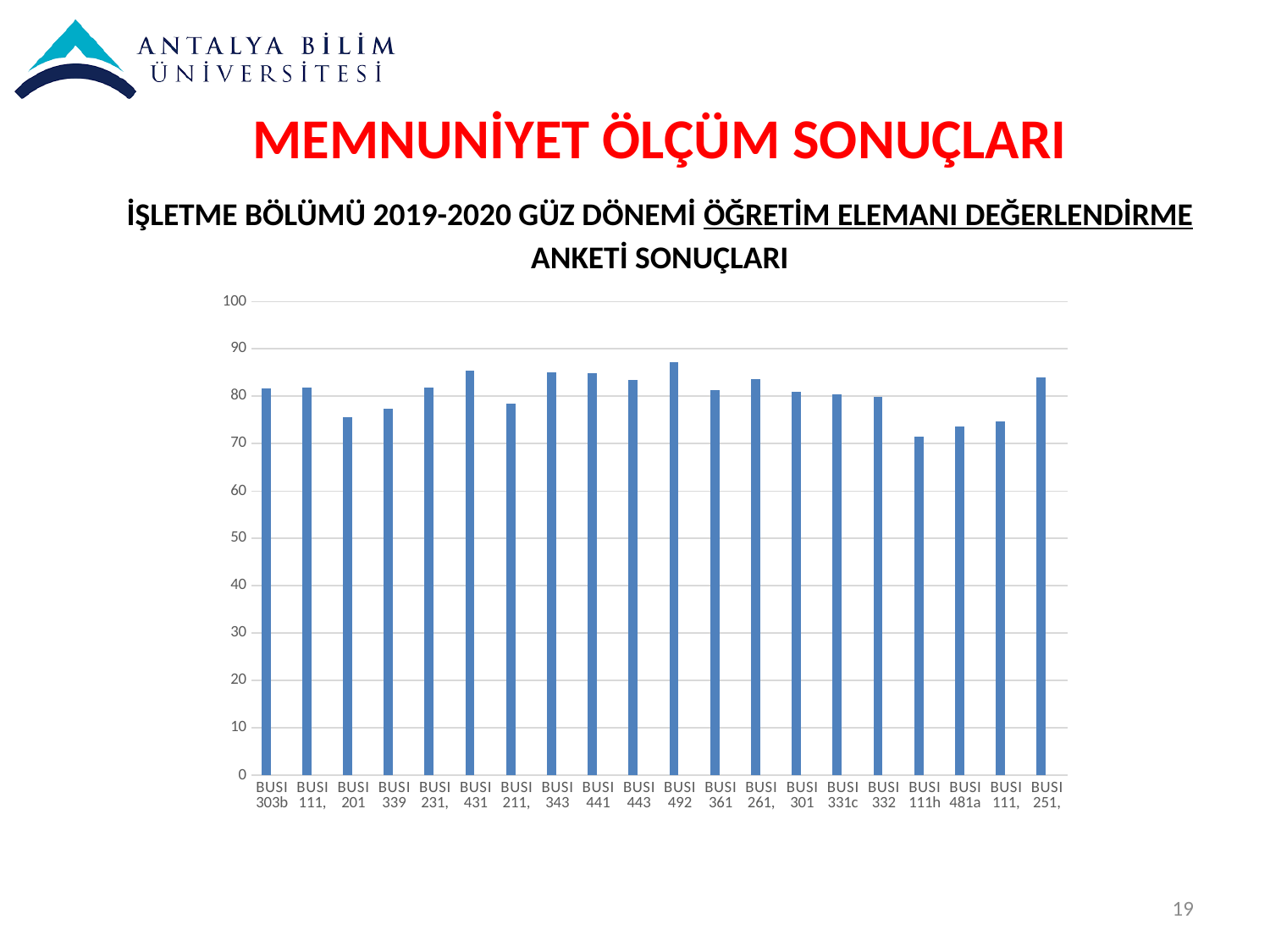
Is the value for BUSI 431 greater or less than 80? greater What is the maximum value shown on the vertical axis of the chart? 100 Is the value for BUSI 201 greater or less than 80? less Which course has the lowest bar in the chart? BUSI 111h Which course has the highest bar in the chart? BUSI 492 How many bars (courses) are plotted in the chart? 20 What kind of chart is shown on the slide? bar chart Which has the larger value, BUSI 431 or BUSI 201? BUSI 431 Is the value for BUSI 111h greater or less than 70? greater Which has the larger value, BUSI 492 or BUSI 111h? BUSI 492